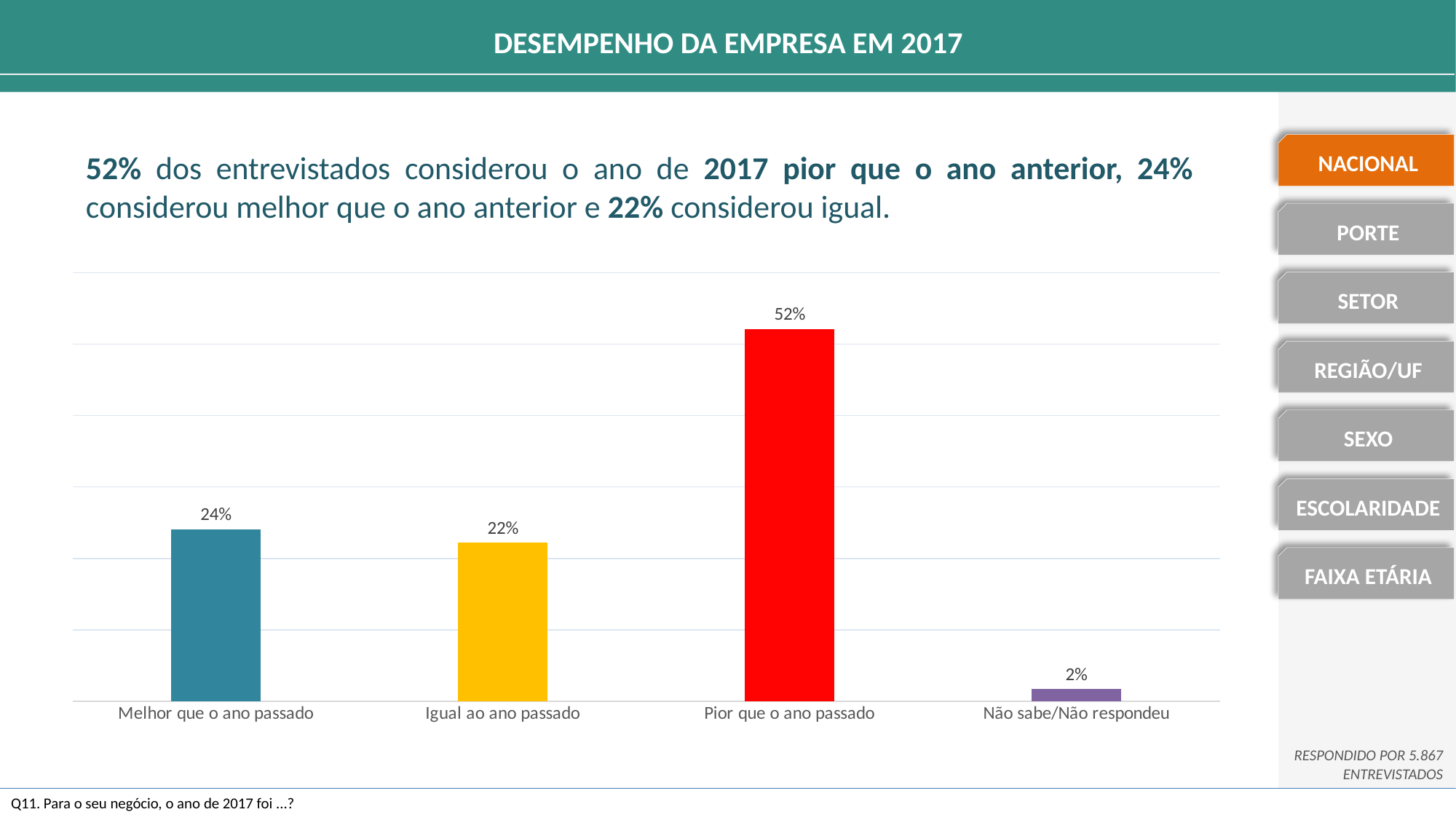
What kind of chart is shown on the slide? Bar chart What is the value for "Igual ao ano passado"? 22% What is the value for "Não sabe/Não respondeu"? 2% Which is larger, the value for "Pior que o ano passado" or the value for "Igual ao ano passado"? Pior que o ano passado Which category has the highest value? Pior que o ano passado What colour is the bar for "Pior que o ano passado"? Red How many categories are shown in the chart? 4 What is the value for "Pior que o ano passado"? 52% What is the difference between the values for "Melhor que o ano passado" and "Igual ao ano passado"? 2% Which category has the lowest value? Não sabe/Não respondeu What is the difference between the values for "Pior que o ano passado" and "Melhor que o ano passado"? 28% What is the value for "Melhor que o ano passado"? 24%